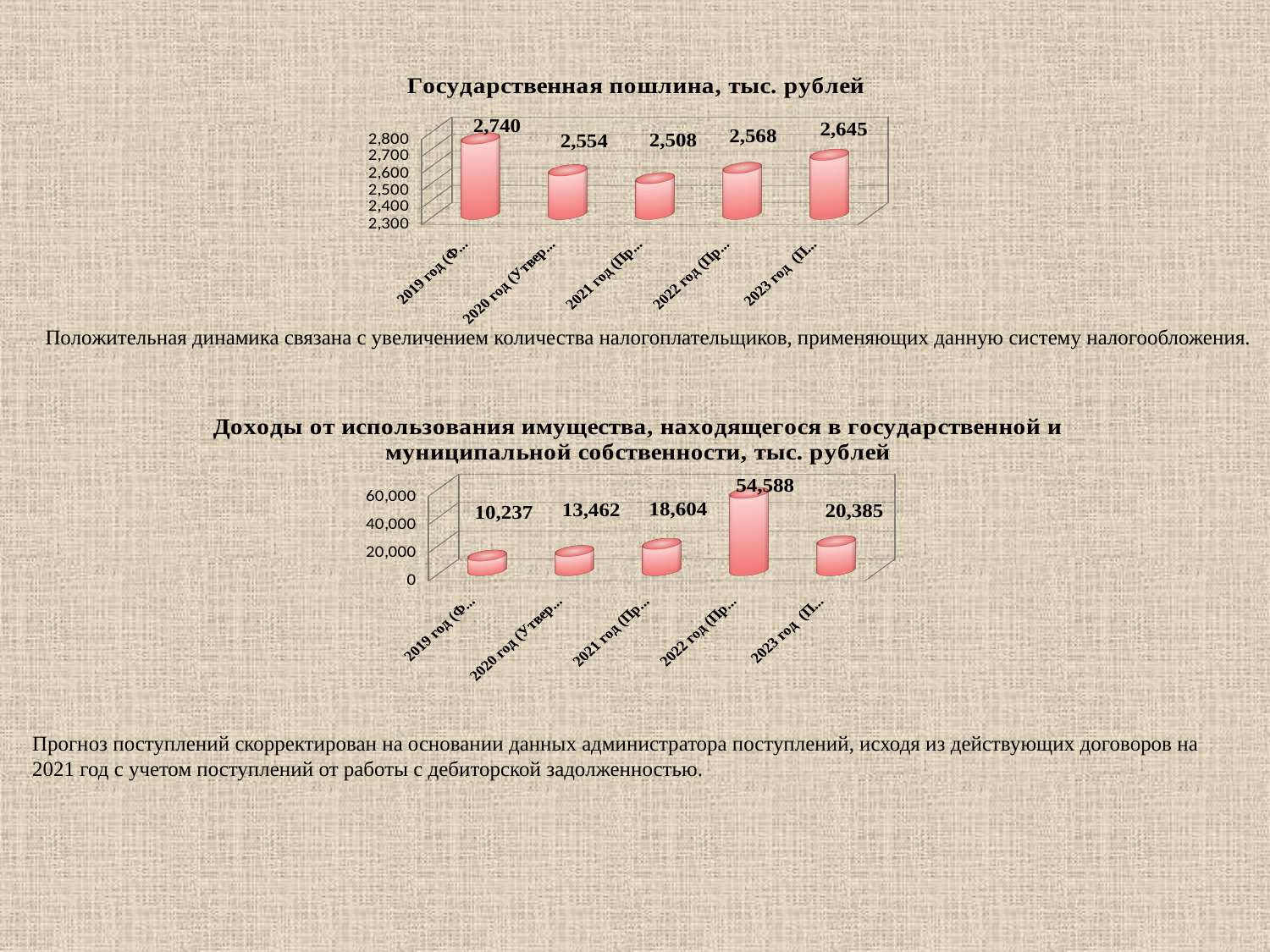
What kind of chart is the bottom chart (Доходы от использования имущества)? bar chart In the chart titled 'Государственная пошлина, тыс. рублей', what is the value for 2019? 2,740 In the bottom chart (Доходы от использования имущества), which year has the highest value? 2022 In the bottom chart (Доходы от использования имущества), what is the value for 2019? 10,237 In the bottom chart (Доходы от использования имущества), what is the difference between the values for 2022 and 2023? 34,203 In the bottom chart (Доходы от использования имущества), is the value for 2023 larger or smaller than the value for 2021? larger In the chart titled 'Государственная пошлина, тыс. рублей', what is the value for 2021? 2,508 In the chart titled 'Государственная пошлина, тыс. рублей', how many bars are plotted? 5 In the chart titled 'Государственная пошлина, тыс. рублей', which year has the highest value? 2019 In the bottom chart (Доходы от использования имущества), what is the value for 2022? 54,588 In the chart titled 'Государственная пошлина, тыс. рублей', what is the difference between the values for 2019 and 2023? 95 In the chart titled 'Государственная пошлина, тыс. рублей', which year has the lowest value? 2021